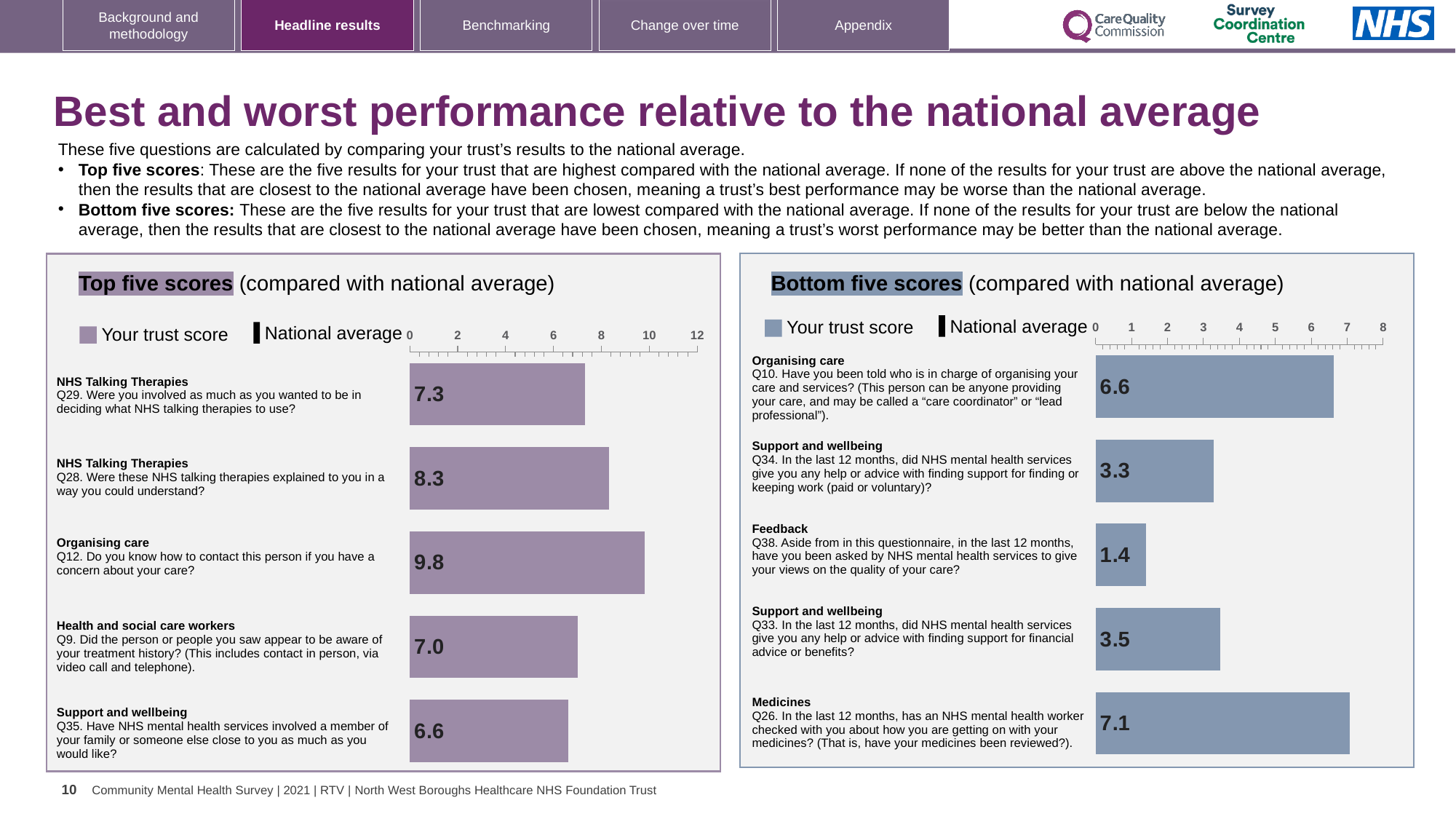
How many entries does the legend of the Bottom five scores chart list? 2 In the Bottom five scores chart, which has the larger trust score, Q34 or Q33? Q33 In the Top five scores chart, which question has the highest trust score? Q12 (Organising care) What kind of chart is the Top five scores chart? Bar chart In the Bottom five scores chart, what is the trust score for Q26 (has an NHS mental health worker checked with you about how you are getting on with your medicines?)? 7.1 In the Top five scores chart, what is the trust score for Q35 (Have NHS mental health services involved a member of your family or someone else close to you as much as you would like?)? 6.6 In the Bottom five scores chart, what is the trust score for Q38 (have you been asked by NHS mental health services to give your views on the quality of your care?)? 1.4 In the Top five scores chart, how many questions are plotted? 5 In the Top five scores chart, what is the difference between the trust scores for Q28 and Q29? 1.0 In the Bottom five scores chart, which question has the lowest trust score? Q38 (Feedback) In the Top five scores chart, what is the trust score for Q12 (Do you know how to contact this person if you have a concern about your care?)? 9.8 In the Bottom five scores chart, what is the difference between the trust scores for Q10 and Q34? 3.3